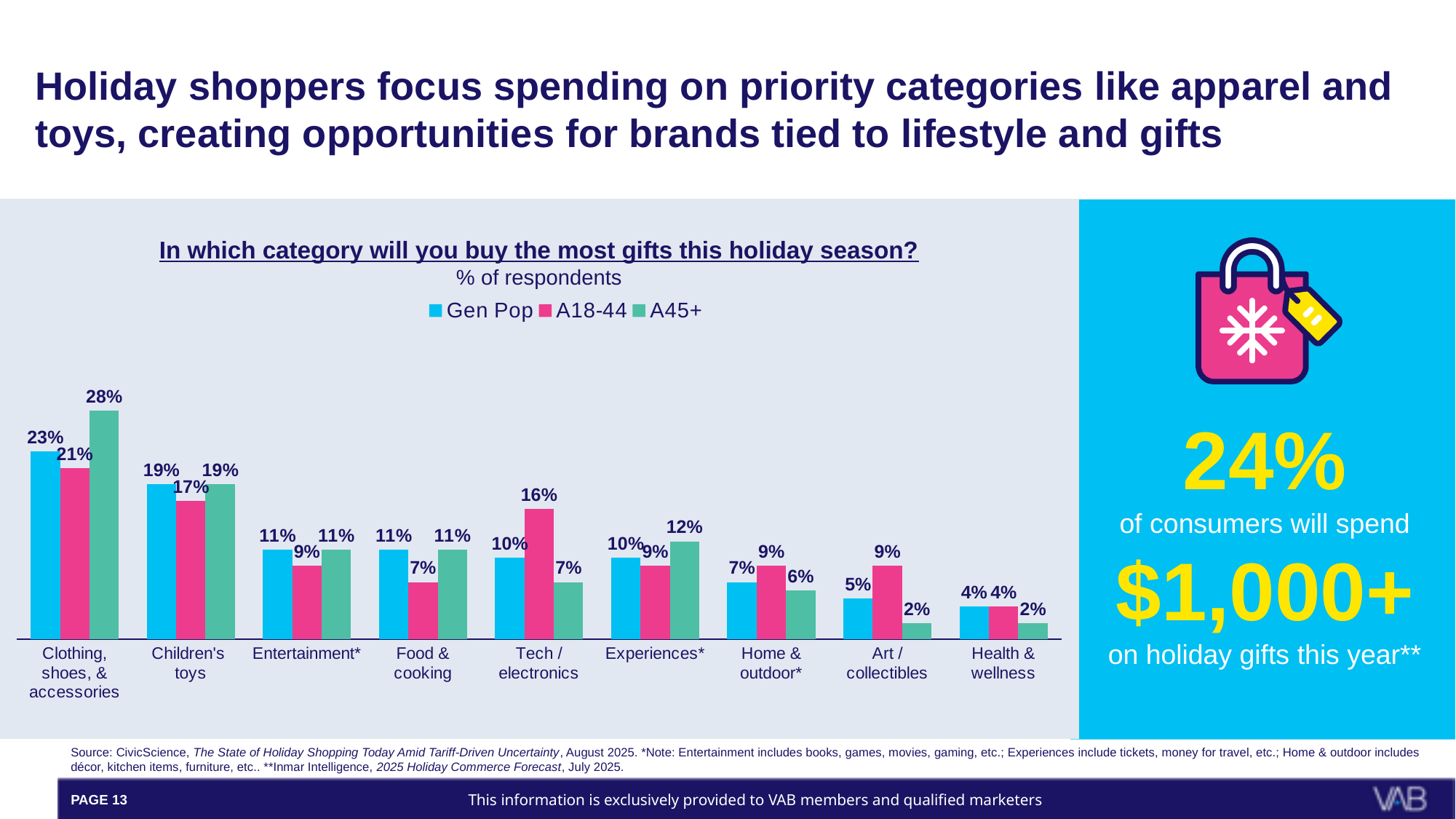
What is the Gen Pop value for Children's toys? 19% Which series is shown in pink in the chart legend? A18-44 For Tech / electronics, which series has the larger value: A18-44 or A45+? A18-44 What kind of chart is shown on the slide? Bar chart How many categories are shown on the x axis of the chart? 9 What is the difference between the Gen Pop values for Children's toys and Health & wellness? 15% What is the A18-44 value for Tech / electronics? 16% How many series does the chart legend list? 3 What is the difference between the A45+ and A18-44 values for Clothing, shoes, & accessories? 7% Which category has the lowest A18-44 value? Health & wellness Which category has the highest Gen Pop value? Clothing, shoes, & accessories What percentage of A45+ respondents will buy the most gifts in the Clothing, shoes, & accessories category? 28%